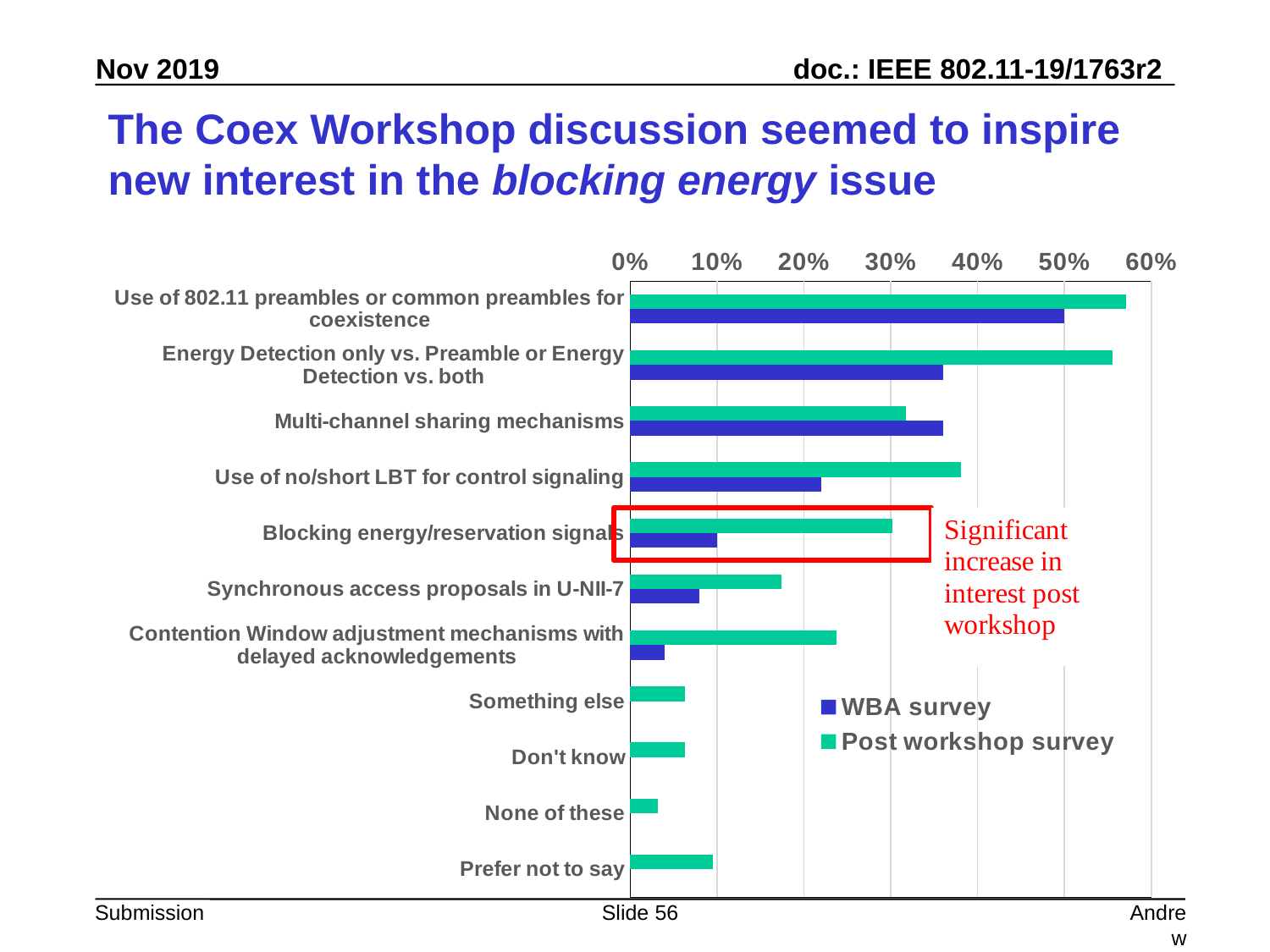
Is the Post workshop survey value for Blocking energy/reservation signals greater or less than 20%? greater Is the WBA survey value for Blocking energy/reservation signals greater or less than 20%? less For Use of no/short LBT for control signaling, which series has the larger value, WBA survey or Post workshop survey? Post workshop survey How many categories are shown on the chart? 11 What kind of chart is shown on the slide? bar chart How many series does the legend list? 2 Is the Post workshop survey value for Energy Detection only vs. Preamble or Energy Detection vs. both greater or less than 50%? greater Which category has the lowest non-zero value in the Post workshop survey series? None of these For Multi-channel sharing mechanisms, which series has the larger value, WBA survey or Post workshop survey? WBA survey Which category has the highest value in the WBA survey series? Use of 802.11 preambles or common preambles for coexistence Which series is shown in green? Post workshop survey Which category has the highest value in the Post workshop survey series? Use of 802.11 preambles or common preambles for coexistence